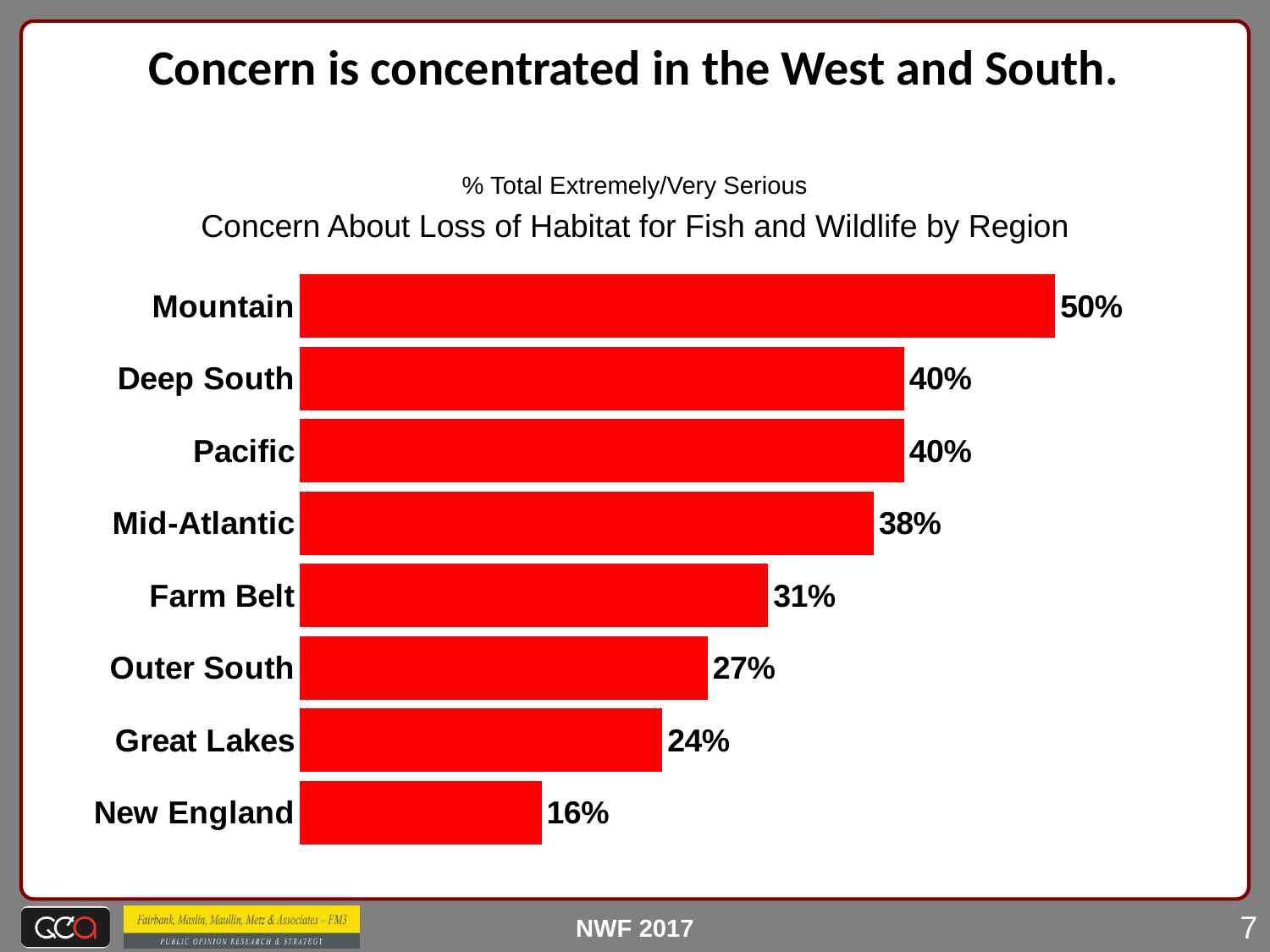
What type of chart is shown on the slide? Bar chart Which has a higher value, Farm Belt or Mid-Atlantic? Mid-Atlantic What is the value shown for the Farm Belt? 31% What is the value shown for New England? 16% What is the difference in percentage points between the Mountain region and New England? 34 What is the title of the chart? Concern About Loss of Habitat for Fish and Wildlife by Region What is the difference in percentage points between Mid-Atlantic and Great Lakes? 14 Which has a higher value, Outer South or Great Lakes? Outer South Which region has the highest percentage of extremely/very serious concern? Mountain How many regions are shown in the chart? 8 What percentage of respondents in the Mountain region rate concern about loss of habitat as extremely/very serious? 50% Which region has the lowest percentage of extremely/very serious concern? New England